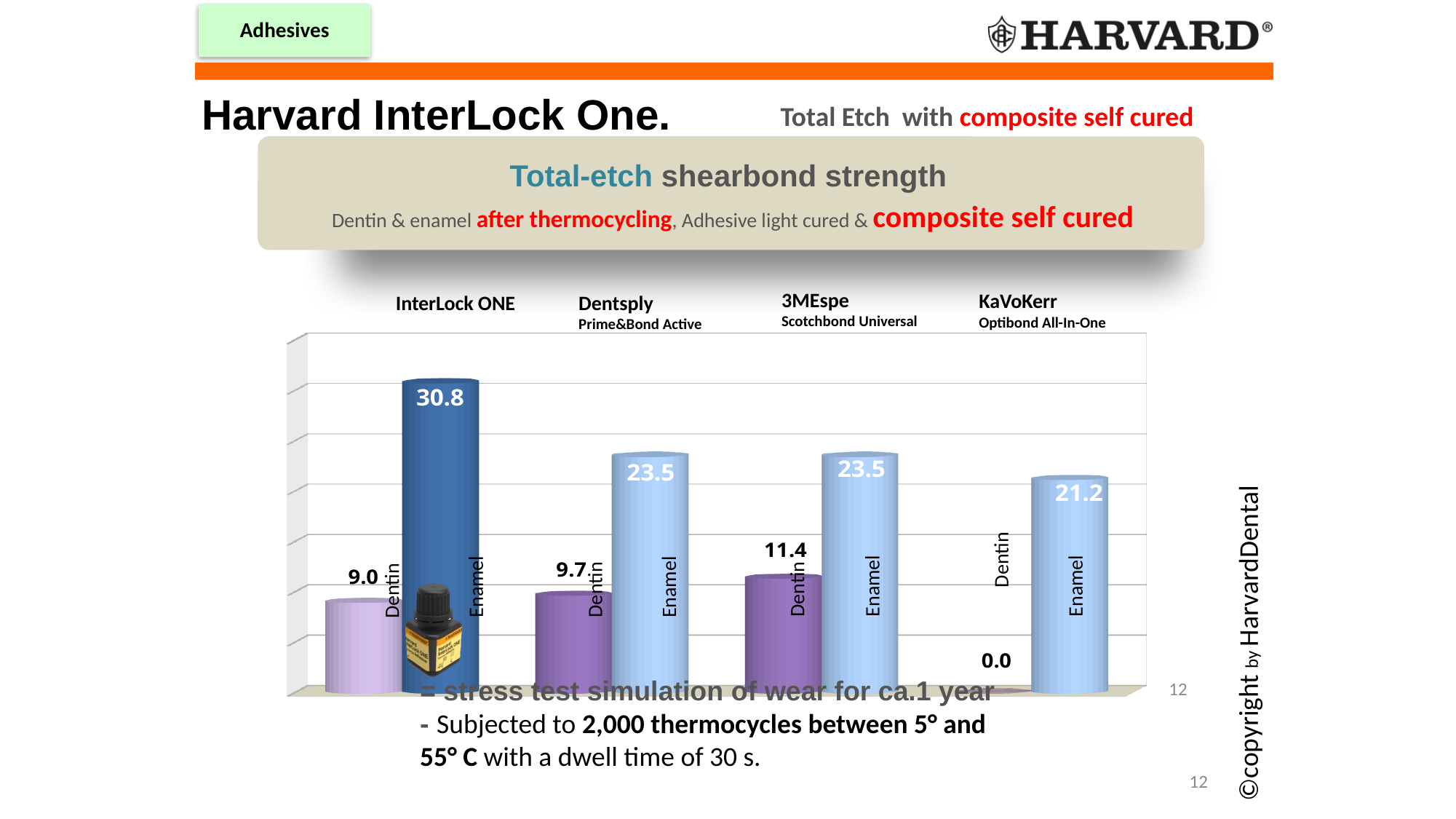
What is the dentin value shown for 3MEspe Scotchbond Universal? 11.4 Which is larger, the dentin value for Dentsply Prime&Bond Active or the dentin value for InterLock ONE? Dentsply Prime&Bond Active What is the difference between the dentin values of 3MEspe Scotchbond Universal and InterLock ONE? 2.4 What is the enamel shear bond strength value shown for InterLock ONE? 30.8 What is the difference between the enamel values of InterLock ONE and KaVoKerr Optibond All-In-One? 9.6 How many products are compared in the chart? 4 Which product has the lowest dentin value? KaVoKerr Optibond All-In-One What is the enamel value shown for Dentsply Prime&Bond Active? 23.5 What is the title shown in the box above the chart? Total-etch shearbond strength Which product has the highest enamel value? InterLock ONE What kind of chart is shown on the slide? Bar chart What is the dentin value shown for KaVoKerr Optibond All-In-One? 0.0